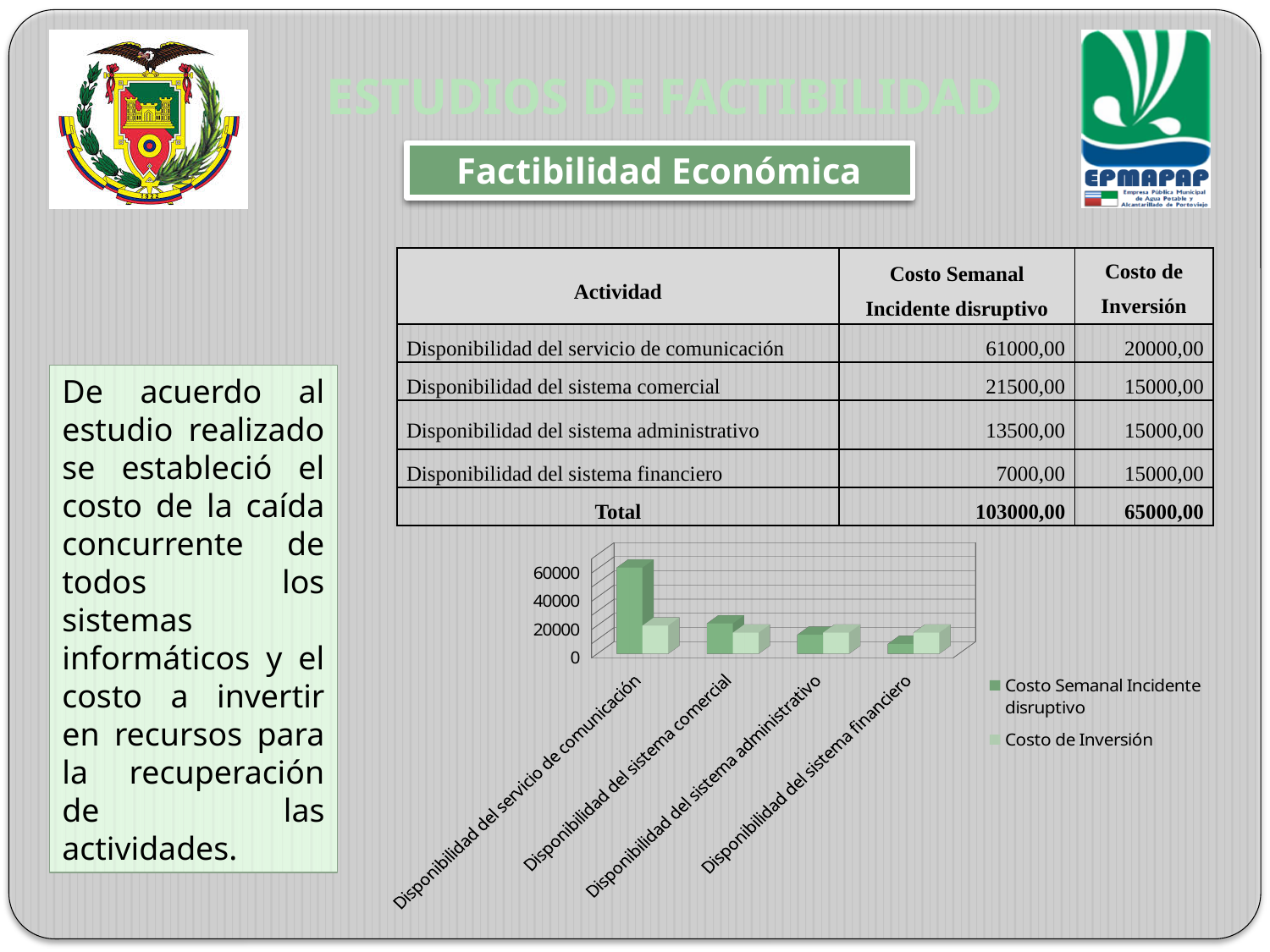
What are the two series named in the chart legend? Costo Semanal Incidente disruptivo; Costo de Inversión What kind of chart is shown below the table on the slide? bar chart According to the table, what is the Costo de Inversión for Disponibilidad del sistema comercial? 15000,00 How many series does the legend of the bar chart list? 2 Which category has the lowest Costo Semanal Incidente disruptivo bar in the chart? Disponibilidad del sistema financiero Is the Costo Semanal Incidente disruptivo value for Disponibilidad del servicio de comunicación greater or less than 40000? greater Do the Costo Semanal Incidente disruptivo bars rise or fall from left to right across the categories? fall How many categories are plotted along the x axis of the bar chart? 4 For Disponibilidad del sistema financiero, which series has the larger bar: Costo Semanal Incidente disruptivo or Costo de Inversión? Costo de Inversión Which category has the highest Costo Semanal Incidente disruptivo bar in the chart? Disponibilidad del servicio de comunicación Is the Costo Semanal Incidente disruptivo value for Disponibilidad del sistema financiero greater or less than 20000? less According to the table, what is the Costo Semanal Incidente disruptivo for Disponibilidad del servicio de comunicación? 61000,00